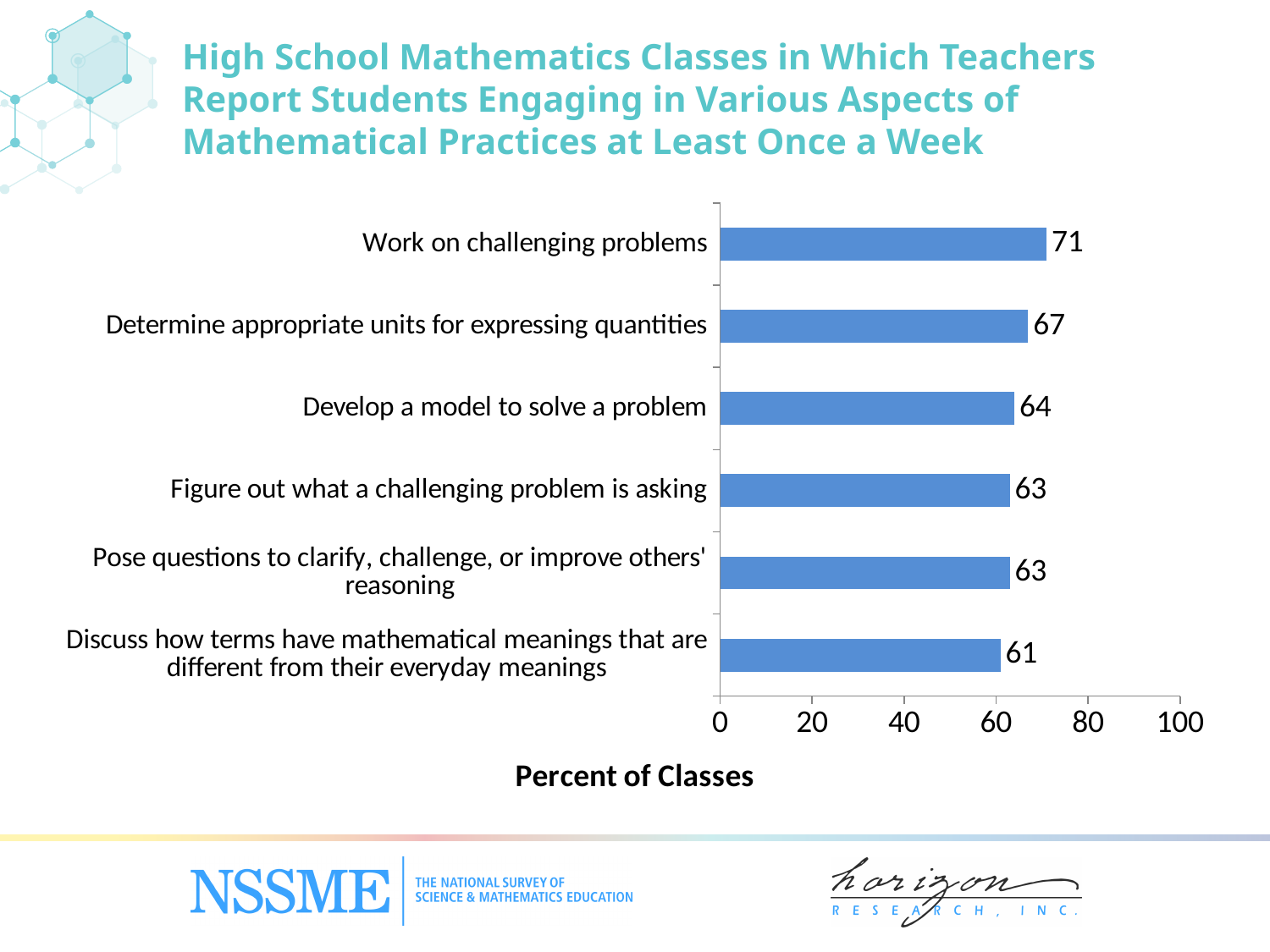
What is the label of the horizontal axis? Percent of Classes What is the value for "Discuss how terms have mathematical meanings that are different from their everyday meanings"? 61 Which is larger: the value for "Determine appropriate units for expressing quantities" or the value for "Figure out what a challenging problem is asking"? Determine appropriate units for expressing quantities What is the value for "Determine appropriate units for expressing quantities"? 67 What is the difference between the values for "Work on challenging problems" and "Develop a model to solve a problem"? 7 What is the value for "Develop a model to solve a problem"? 64 Which category has the lowest percent of classes? Discuss how terms have mathematical meanings that are different from their everyday meanings What kind of chart is shown on the slide? bar chart How many categories are shown in the chart? 6 Is the value for "Pose questions to clarify, challenge, or improve others' reasoning" greater or less than 80? less Which category has the highest percent of classes? Work on challenging problems What percent of classes is reported for "Work on challenging problems"? 71